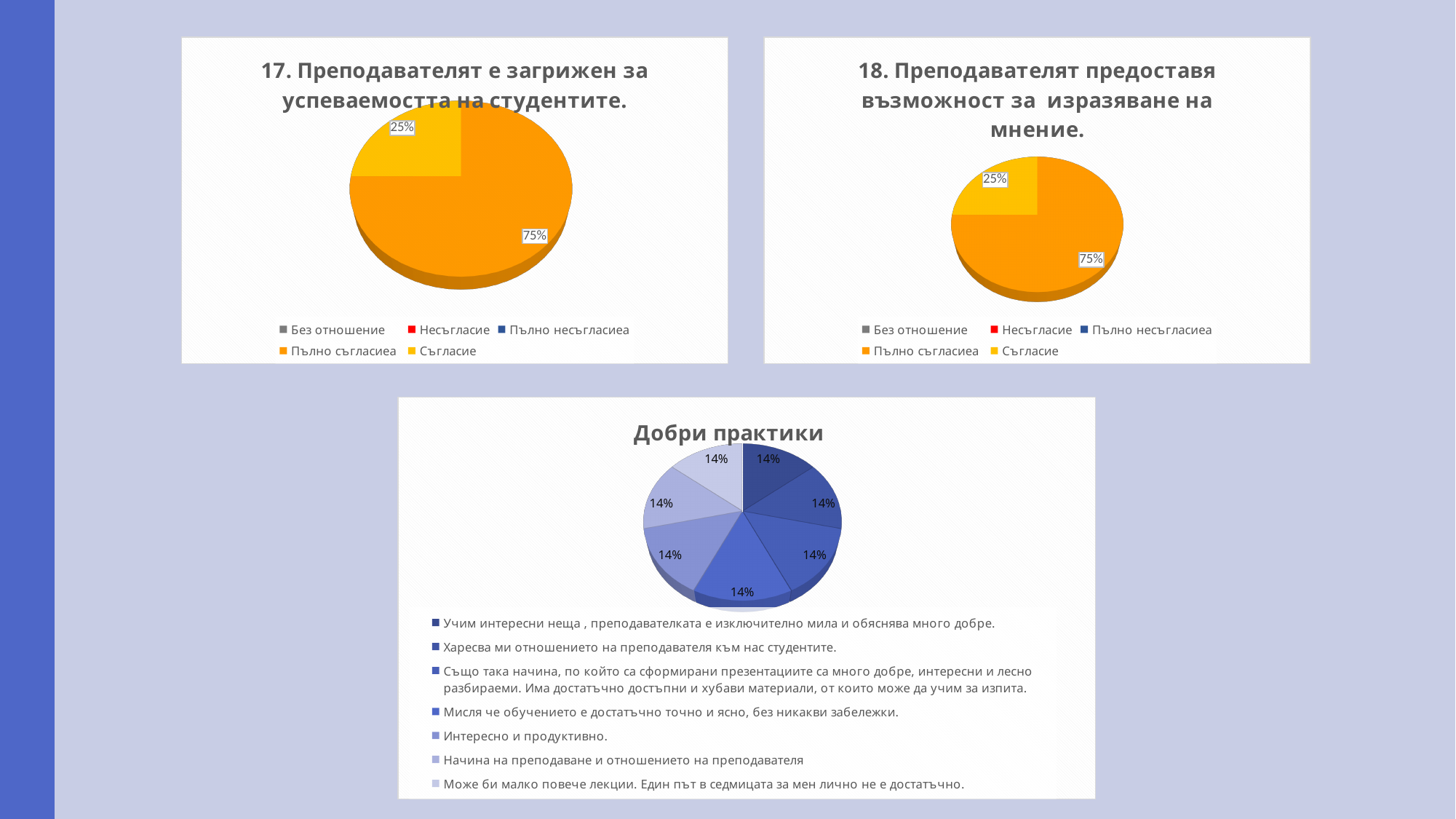
In the chart titled "Добри практики", how many slices does the pie have? 7 In the chart titled "17. Преподавателят е загрижен за успеваемостта на студентите.", which category has the largest slice? Пълно съгласиеа In the chart titled "18. Преподавателят предоставя възможност за изразяване на мнение.", what share of the pie is "Пълно съгласиеа"? 75% In the chart titled "18. Преподавателят предоставя възможност за изразяване на мнение.", what share of the pie is "Съгласие"? 25% In the chart titled "17. Преподавателят е загрижен за успеваемостта на студентите.", what share of the pie is "Съгласие"? 25% In the chart titled "18. Преподавателят предоставя възможност за изразяване на мнение.", which is larger, "Пълно съгласиеа" or "Съгласие"? Пълно съгласиеа In the chart titled "17. Преподавателят е загрижен за успеваемостта на студентите.", what colour is the "Съгласие" slice? Yellow How many entries does the legend of the chart titled "18. Преподавателят предоставя възможност за изразяване на мнение." list? 5 In the chart titled "17. Преподавателят е загрижен за успеваемостта на студентите.", what is the difference between the "Пълно съгласиеа" and "Съгласие" shares? 50% What kind of chart is the chart titled "Добри практики"? Pie chart